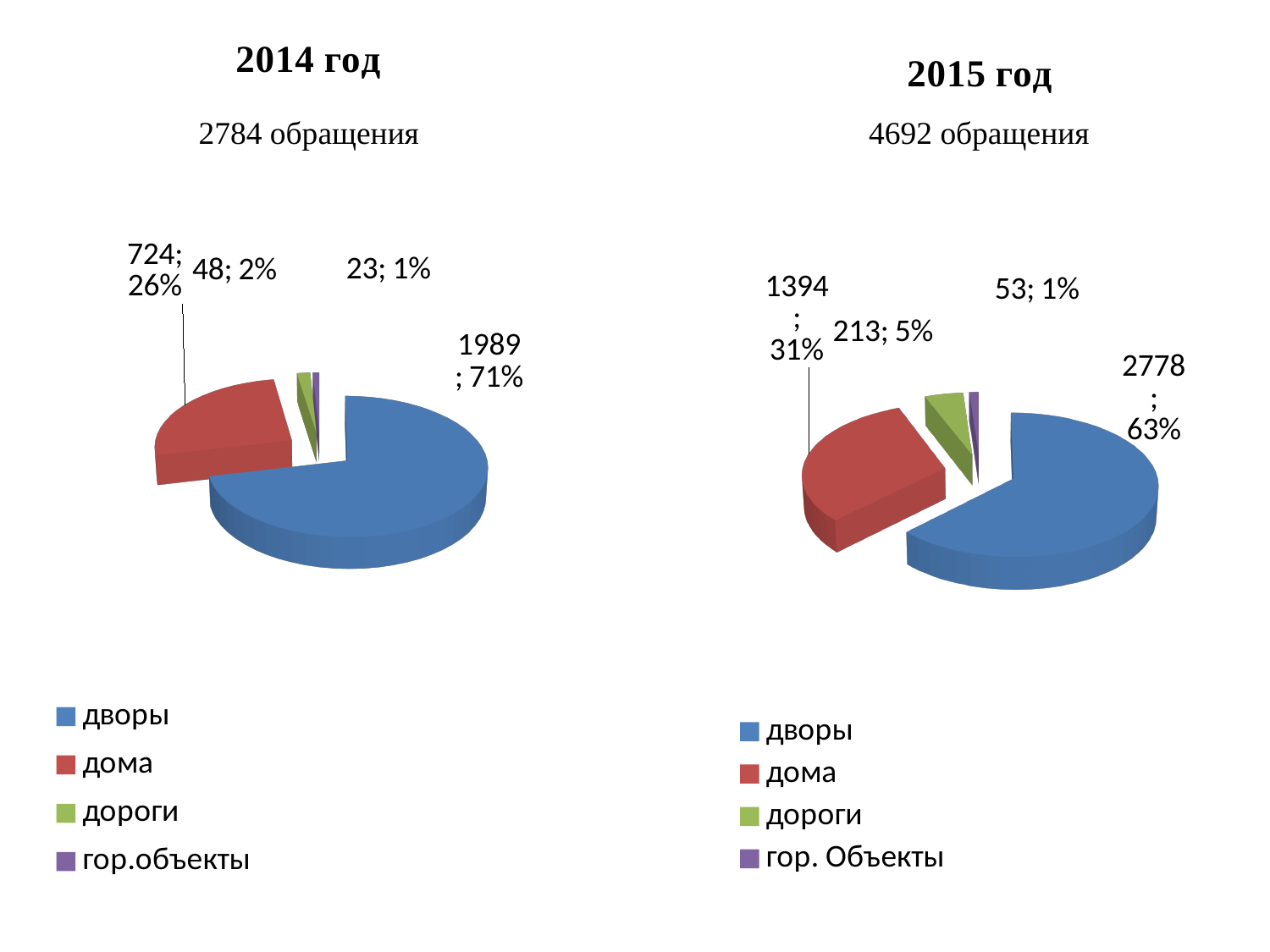
What type of chart is the 2014 год chart? pie chart In the 2014 год chart, which category has the largest slice? дворы In the 2015 год chart, what value is shown for дороги? 213 In the 2014 год chart, which colour represents дома? red In the 2014 год chart, what value is shown for дворы? 1989 In the 2015 год chart, which category has the smallest slice? гор. Объекты In the 2014 год chart, what percentage share does дома have? 26% In the 2014 год chart, which is larger, the value for дороги or the value for гор.объекты? дороги In the 2015 год chart, what is the difference between the values for дворы and дома? 1384 How many categories does the legend of the 2015 год chart list? 4 In the 2015 год chart, what percentage share does дворы have? 63% In the 2015 год chart, what value is shown for дома? 1394